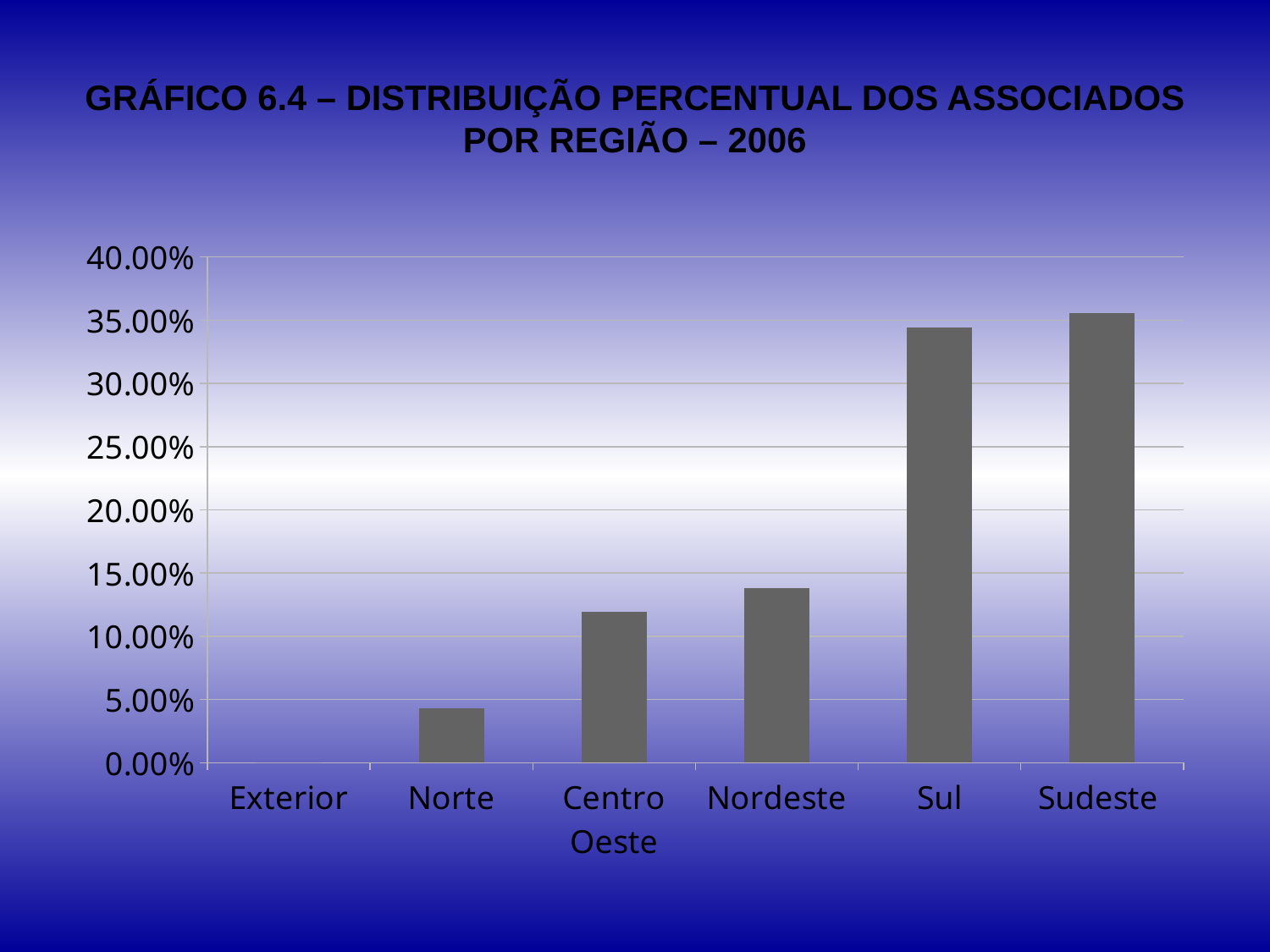
Is the value for Centro Oeste greater or less than 10.00%? greater Do the values generally rise or fall moving from left to right along the x axis? rise Is the value for Nordeste greater or less than 15.00%? less What kind of chart is shown on the slide? bar chart Is the value for Sul greater or less than 30.00%? greater How many regions (categories) are shown on the x axis? 6 Which year does the chart title refer to? 2006 Which region has the lowest value? Exterior Which is larger, the value for Sul or the value for Norte? Sul Which is larger, the value for Nordeste or the value for Centro Oeste? Nordeste